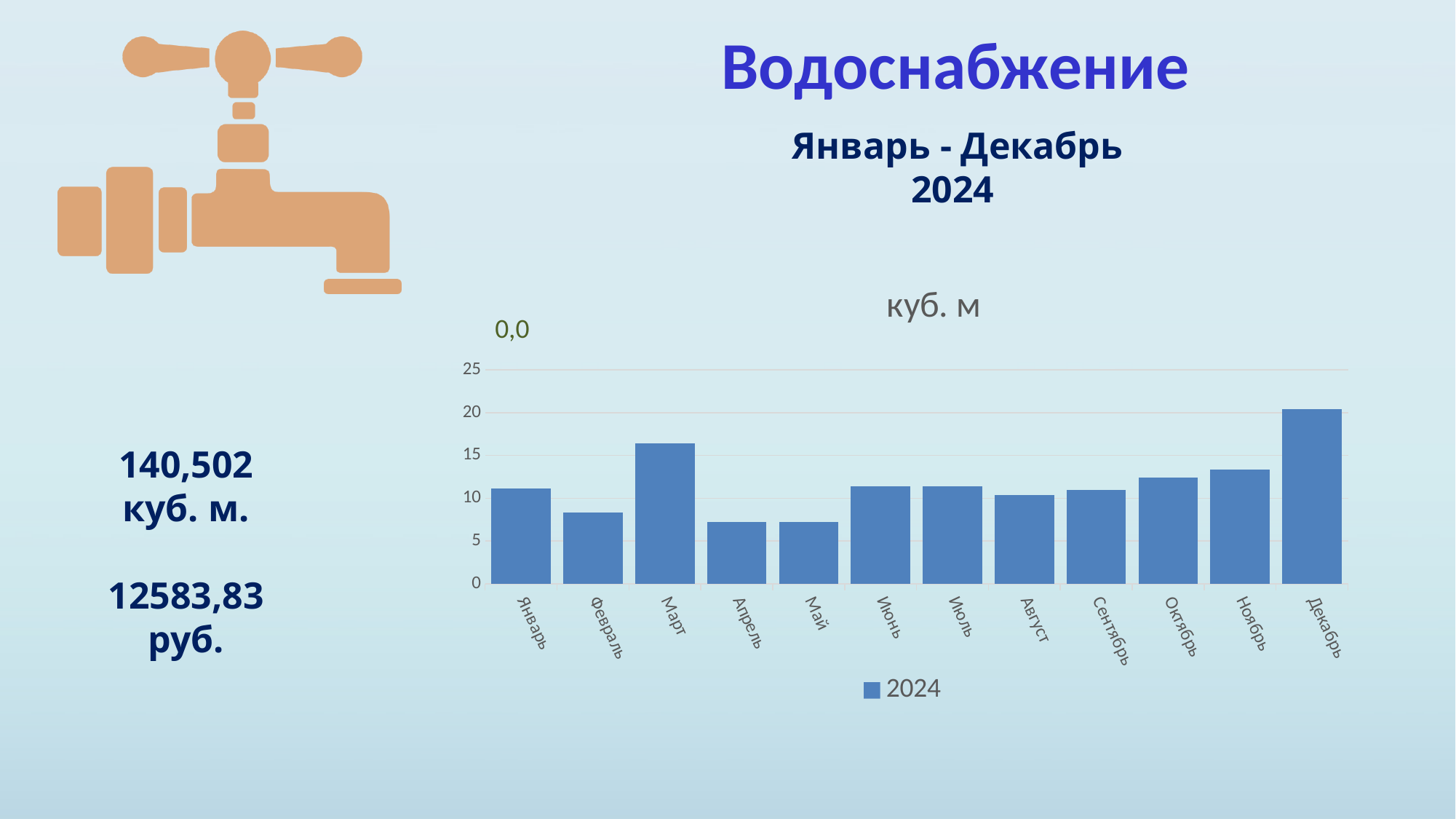
Which is larger, the value for Март or the value for Февраль? Март Is the value for Апрель greater or less than 10? less Is the value for Февраль greater or less than 10? less What is the title of the chart? куб. м What series name is shown in the chart legend? 2024 How many categories (months) are plotted on the chart? 12 Is the value for Март greater or less than 15? greater What kind of chart is shown on the slide? bar chart Which is larger, the value for Декабрь or the value for Январь? Декабрь Which month has the highest value on the chart? Декабрь How many series does the chart legend list? 1